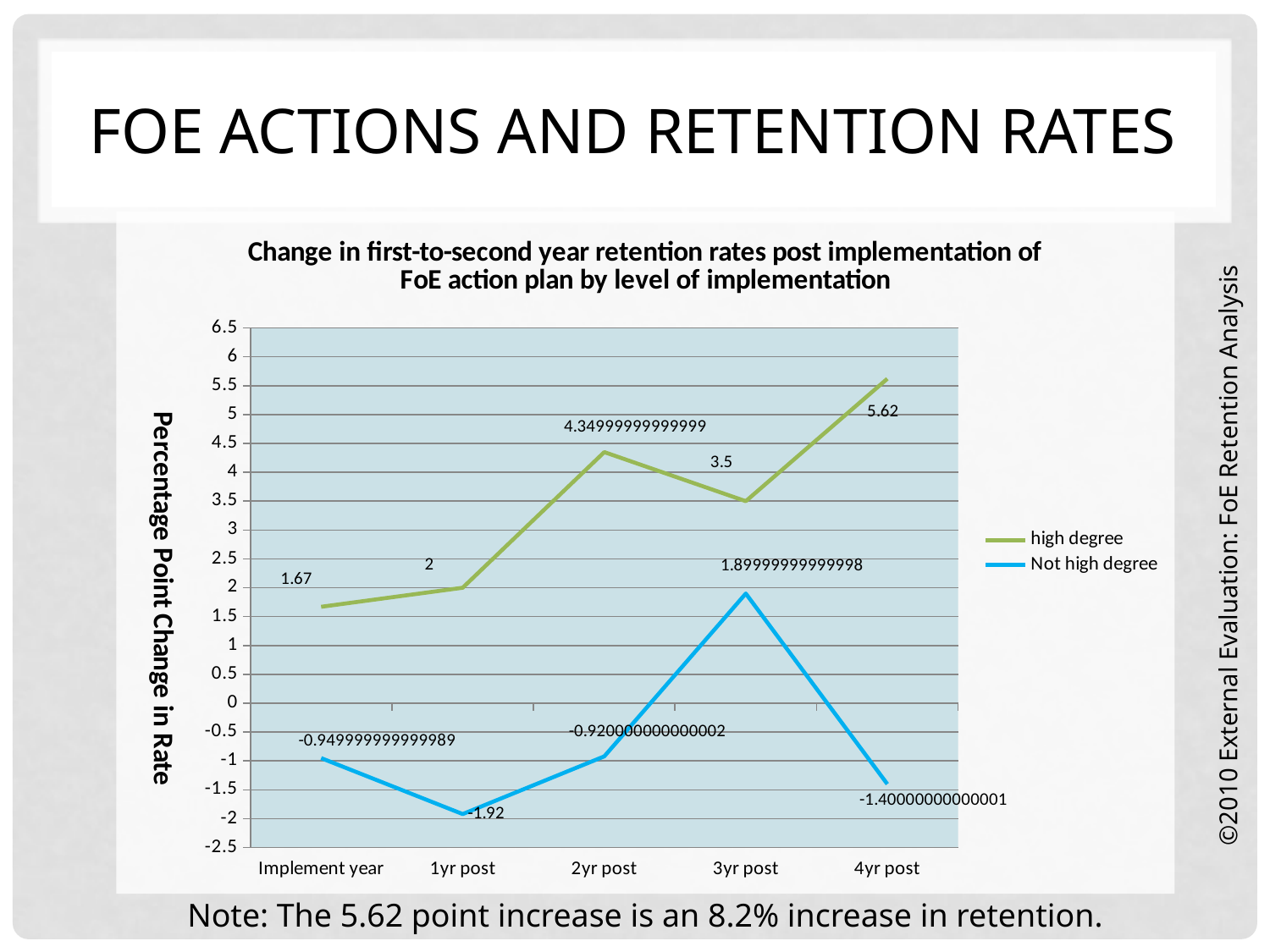
What is the value for the high degree series at Implement year? 1.67 At which x-axis category does the Not high degree series reach its lowest value? 1yr post How many points along the x axis does each line have? 5 How many series does the legend list? 2 Which series has the larger value at 3yr post, high degree or Not high degree? high degree What type of chart is shown on the slide? line chart What is the value for the Not high degree series at 1yr post? -1.92 What is the value for the high degree series at 3yr post? 3.5 What is the difference between the high degree values at 4yr post and Implement year? 3.95 What is the value for the high degree series at 4yr post? 5.62 What is the title of the chart? Change in first-to-second year retention rates post implementation of FoE action plan by level of implementation At which x-axis category does the high degree series reach its highest value? 4yr post